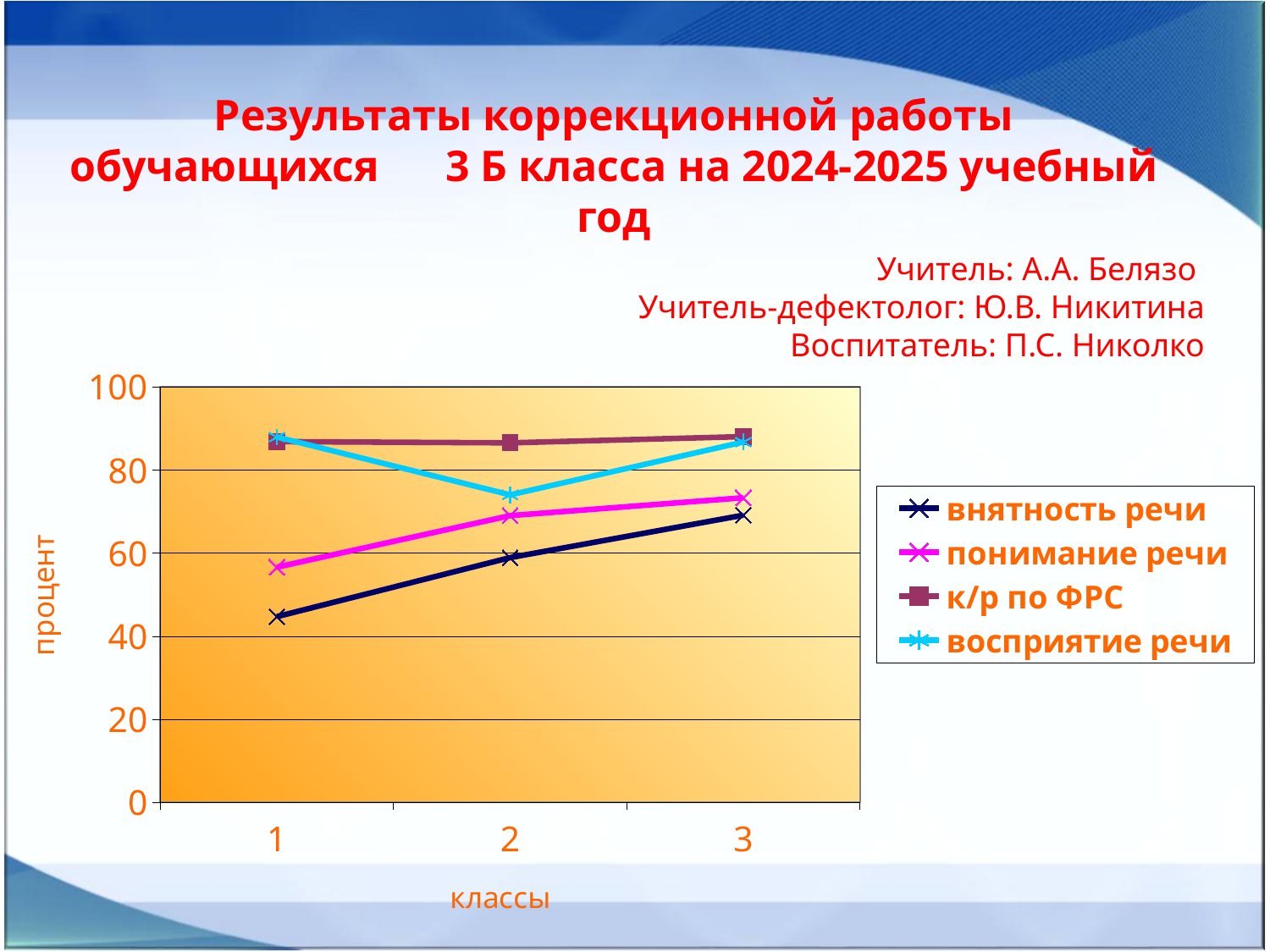
How many categories are shown on the x axis? 3 Does the внятность речи series rise or fall from class 1 to class 3? rises How many series does the legend list? 4 Is the value for внятность речи at class 1 greater or less than 60? less Is the value for внятность речи at class 1 greater or less than 40? greater Is the value for к/р по ФРС at class 2 greater or less than 80? greater Which series has the lowest value at class 1? внятность речи What kind of chart is shown on the slide? line chart At class 1, which is larger: внятность речи or понимание речи? понимание речи What is the label of the vertical axis? процент